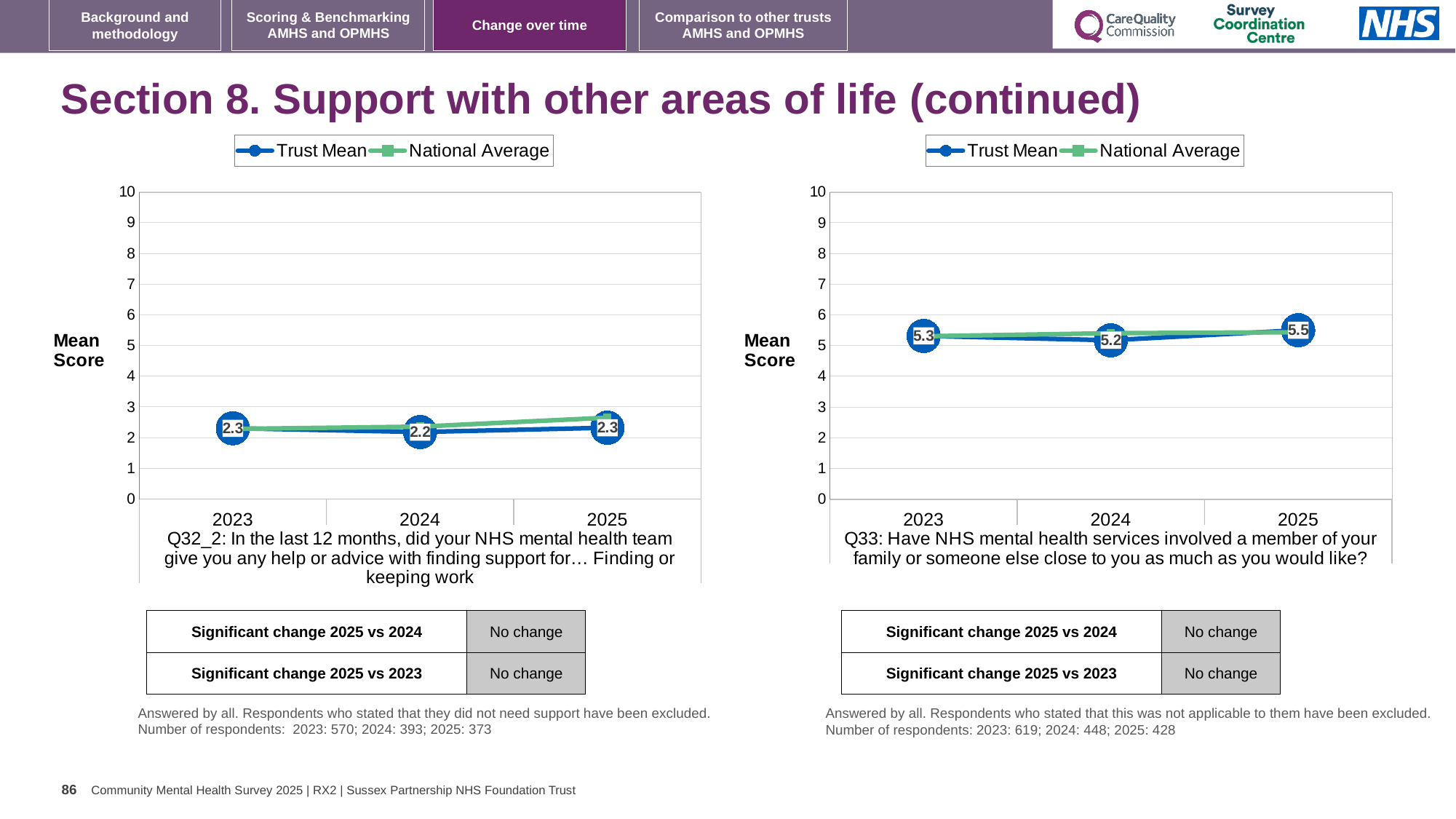
How many years are plotted on the x axis of the right chart (Q33)? 3 In the right chart (Q33), what is the difference between the Trust Mean for 2025 and the Trust Mean for 2024? 0.3 In the left chart (Q32_2), is the National Average for 2025 greater or less than 3? less In the left chart (Q32_2), what is the Trust Mean for 2023? 2.3 In the left chart (Q32_2), what is the Trust Mean for 2024? 2.2 In the right chart (Q33), what is the Trust Mean for 2025? 5.5 In the left chart (Q32_2), which year has the lowest Trust Mean? 2024 In the right chart (Q33), which year has the highest Trust Mean? 2025 In the right chart (Q33), which year has the lowest Trust Mean? 2024 In the right chart (Q33), is the Trust Mean for 2023 larger or smaller than the Trust Mean for 2024? larger What kind of chart is the right chart (Q33)? line chart How many series does the legend of the left chart (Q32_2) list? 2